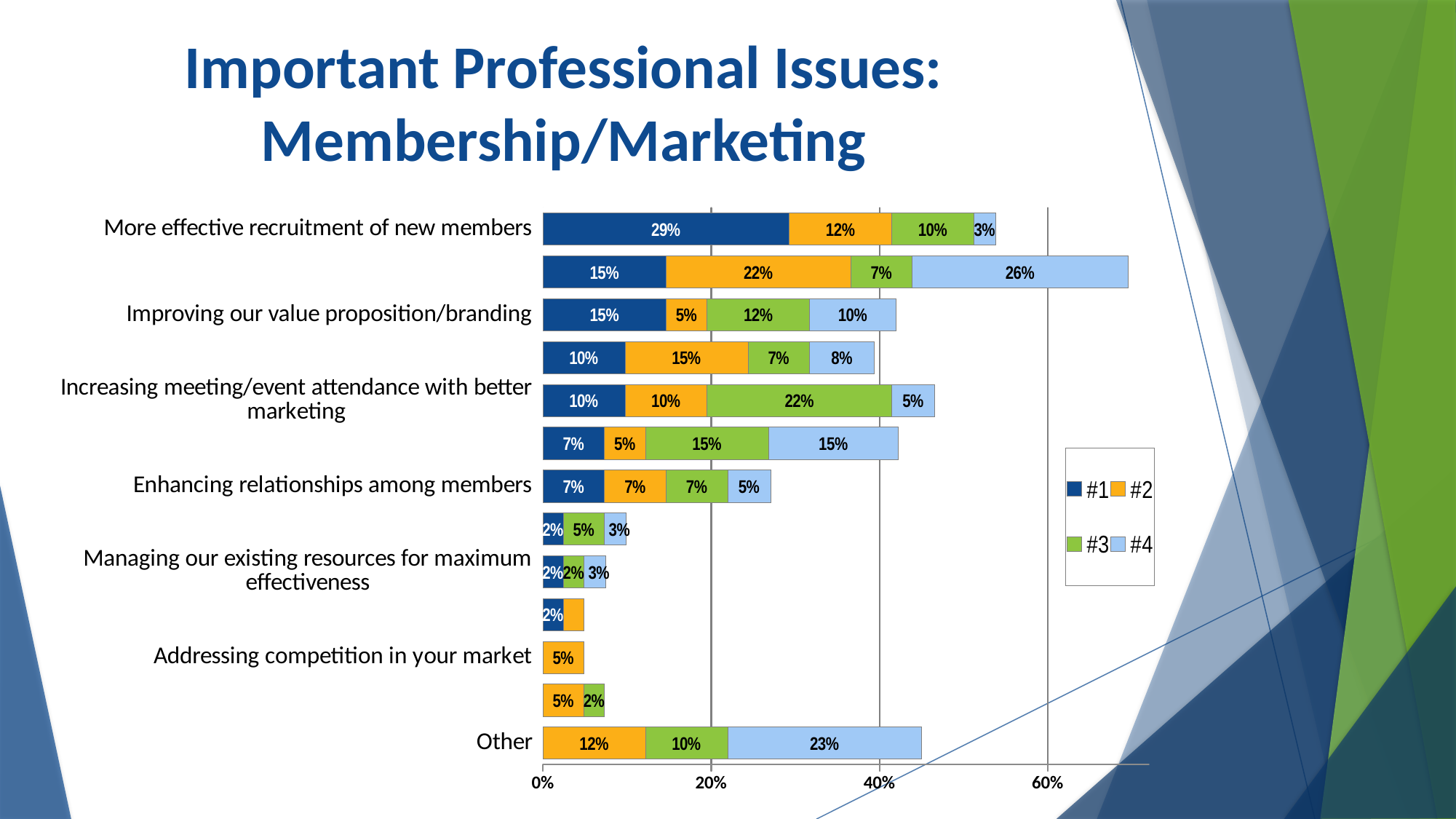
Is the total stacked bar for 'Other' greater or less than 40%? greater How many series does the legend list? 4 What is the #4 value for 'Other'? 23% Which is larger: the #3 value for 'Increasing meeting/event attendance with better marketing' or the #3 value for 'Improving our value proposition/branding'? Increasing meeting/event attendance with better marketing What is the #2 value for 'Addressing competition in your market'? 5% What is the total of the stacked bar for 'Enhancing relationships among members'? 26% What is the #1 value for 'More effective recruitment of new members'? 29% What type of chart is shown on the slide? Stacked bar chart What is the difference between the #1 values for 'More effective recruitment of new members' and 'Improving our value proposition/branding'? 14% What is the #3 value for 'Increasing meeting/event attendance with better marketing'? 22% What is the total of the stacked bar for 'More effective recruitment of new members'? 54% What is the #4 value for 'Improving our value proposition/branding'? 10%